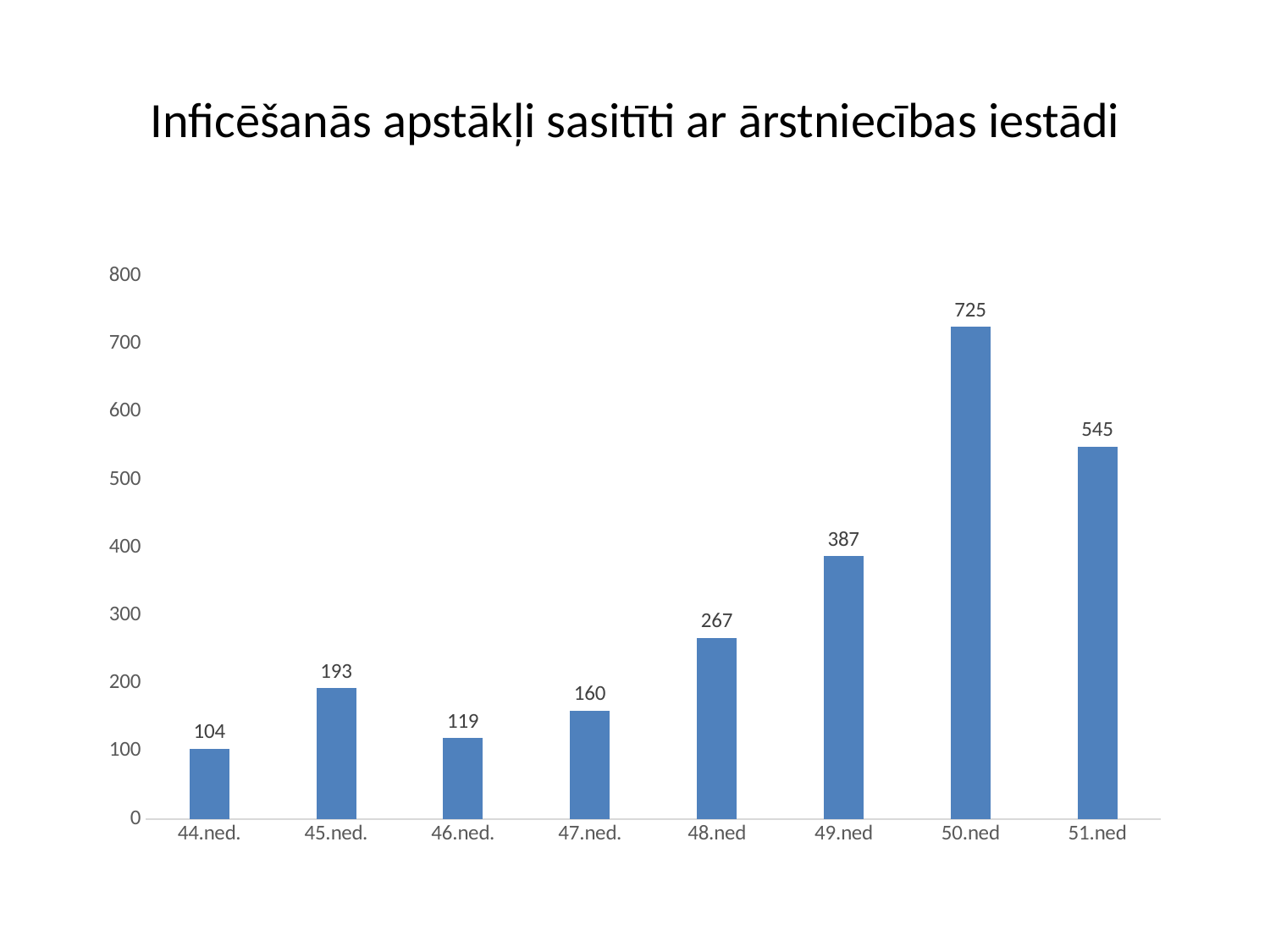
What is the title of the chart? Inficēšanās apstākļi sasitīti ar ārstniecības iestādi What is the difference between the values for 49.ned and 48.ned? 120 Is the value for 49.ned greater or less than 300? greater What is the value for 44.ned.? 104 What is the value for 51.ned? 545 What kind of chart is shown on the slide? bar chart Which week has the lowest value? 44.ned. What is the difference between the values for 50.ned and 51.ned? 180 How many weeks are shown on the x axis? 8 What is the value for 48.ned? 267 Which week has the highest value? 50.ned Which is larger, the value for 45.ned. or the value for 47.ned.? 45.ned.